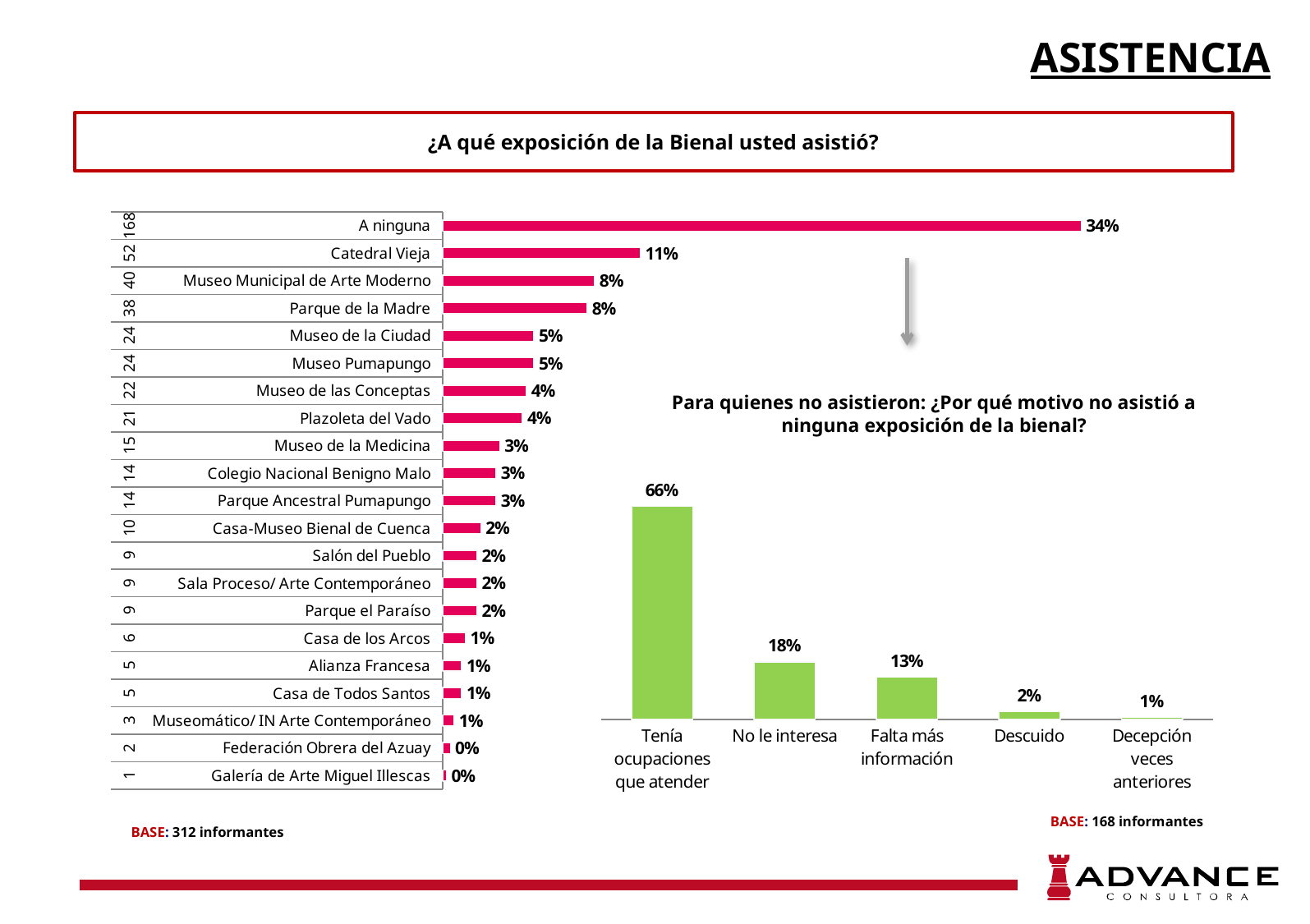
In the chart '¿A qué exposición de la Bienal usted asistió?', what is the value for Catedral Vieja? 11% In the chart 'Para quienes no asistieron: ¿Por qué motivo no asistió a ninguna exposición de la bienal?', what is the value for No le interesa? 18% In the chart '¿A qué exposición de la Bienal usted asistió?', which category has the highest value? A ninguna How many categories are shown in the chart '¿A qué exposición de la Bienal usted asistió?'? 21 In the chart '¿A qué exposición de la Bienal usted asistió?', what is the difference between the values for A ninguna and Catedral Vieja? 23% In the chart 'Para quienes no asistieron: ¿Por qué motivo no asistió a ninguna exposición de la bienal?', which category has the lowest value? Decepción veces anteriores In the chart '¿A qué exposición de la Bienal usted asistió?', which is larger: the value for Museo de la Ciudad or the value for Casa-Museo Bienal de Cuenca? Museo de la Ciudad In the chart '¿A qué exposición de la Bienal usted asistió?', what is the value for Museo de las Conceptas? 4% How many categories are shown in the chart 'Para quienes no asistieron: ¿Por qué motivo no asistió a ninguna exposición de la bienal?'? 5 What kind of chart is '¿A qué exposición de la Bienal usted asistió?'? bar chart In the chart 'Para quienes no asistieron: ¿Por qué motivo no asistió a ninguna exposición de la bienal?', do the values rise or fall from left to right? fall In the chart 'Para quienes no asistieron: ¿Por qué motivo no asistió a ninguna exposición de la bienal?', what is the difference between the values for Tenía ocupaciones que atender and Falta más información? 53%